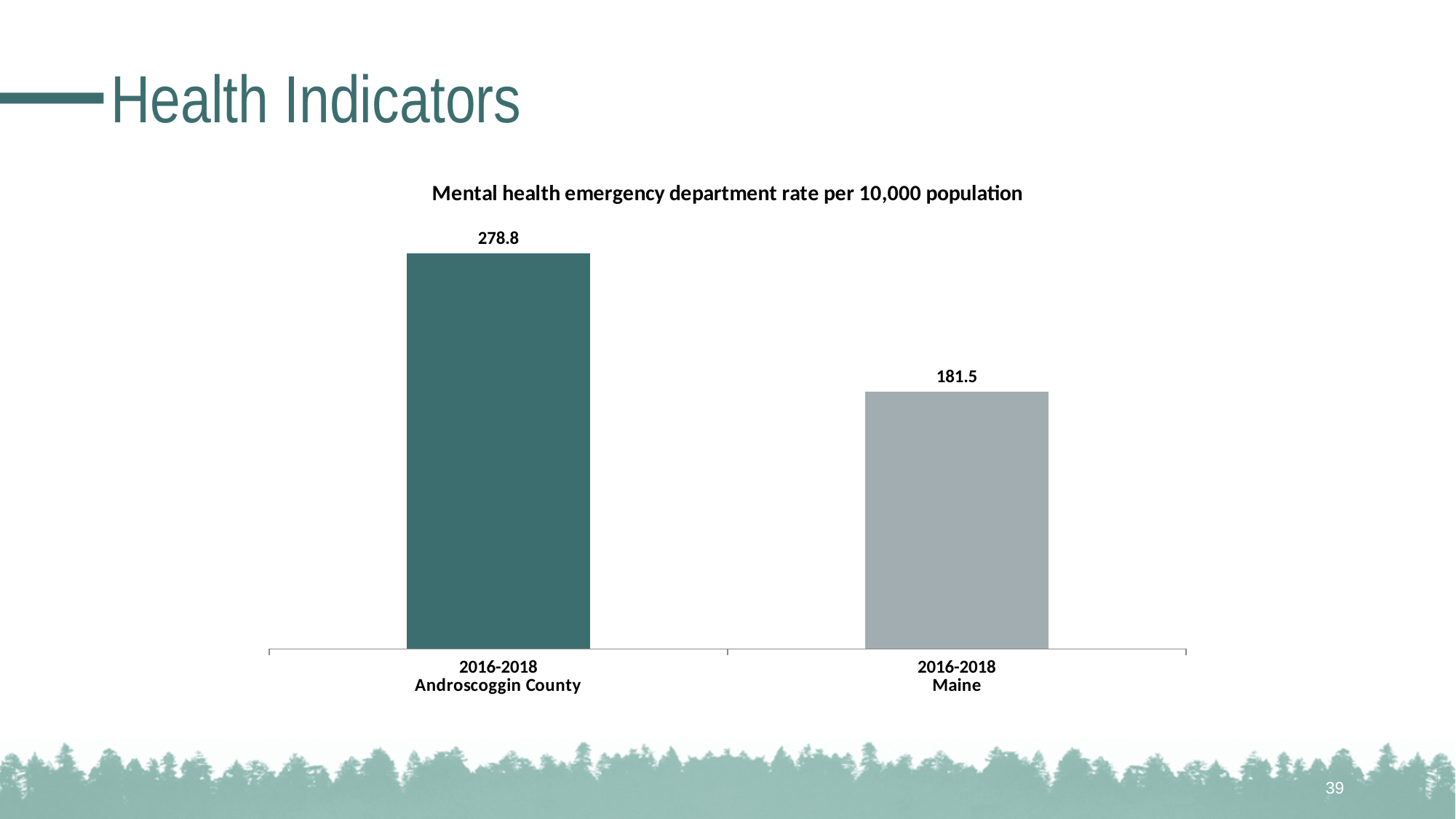
What is the difference between the Androscoggin County rate and the Maine rate? 97.3 What is the title of the chart? Mental health emergency department rate per 10,000 population How many bars are shown in the chart? 2 What is the mental health emergency department rate per 10,000 population for Androscoggin County (2016-2018)? 278.8 Is the rate for Androscoggin County larger or smaller than the rate for Maine? larger Which category has the lower mental health emergency department rate? Maine What is the mental health emergency department rate per 10,000 population for Maine (2016-2018)? 181.5 Which category has the higher mental health emergency department rate? Androscoggin County What time period do both bars in the chart cover? 2016-2018 What kind of chart is shown on the slide? bar chart